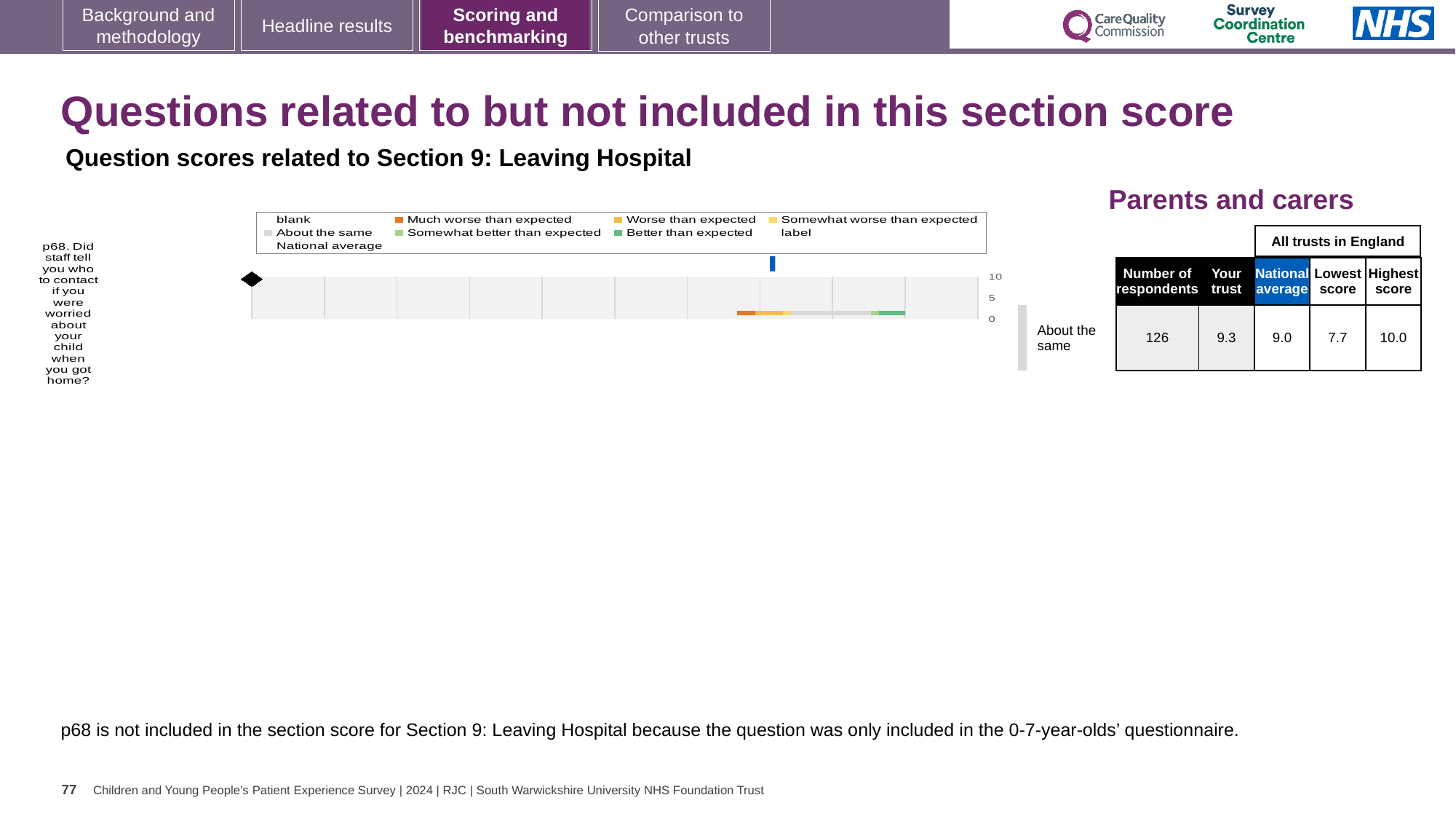
What is the difference between the 'Your trust' score and the National average for p68? 0.3 According to the table next to the chart, what is the 'Your trust' score for p68? 9.3 According to the table next to the chart, what is the Lowest score among all trusts in England for p68? 7.7 What category label is shown to the right of the chart for question p68? About the same According to the table next to the chart, what is the National average score for p68? 9.0 According to the table next to the chart, what is the Highest score among all trusts in England for p68? 10.0 What is the highest value shown on the chart's axis? 10 Which is larger for p68, the 'Your trust' score or the National average? Your trust Which question is plotted in the chart? p68. Did staff tell you who to contact if you were worried about your child when you got home? According to the table next to the chart, how many respondents answered p68? 126 What kind of chart is shown on the slide? bar chart How many questions are plotted in the chart? 1